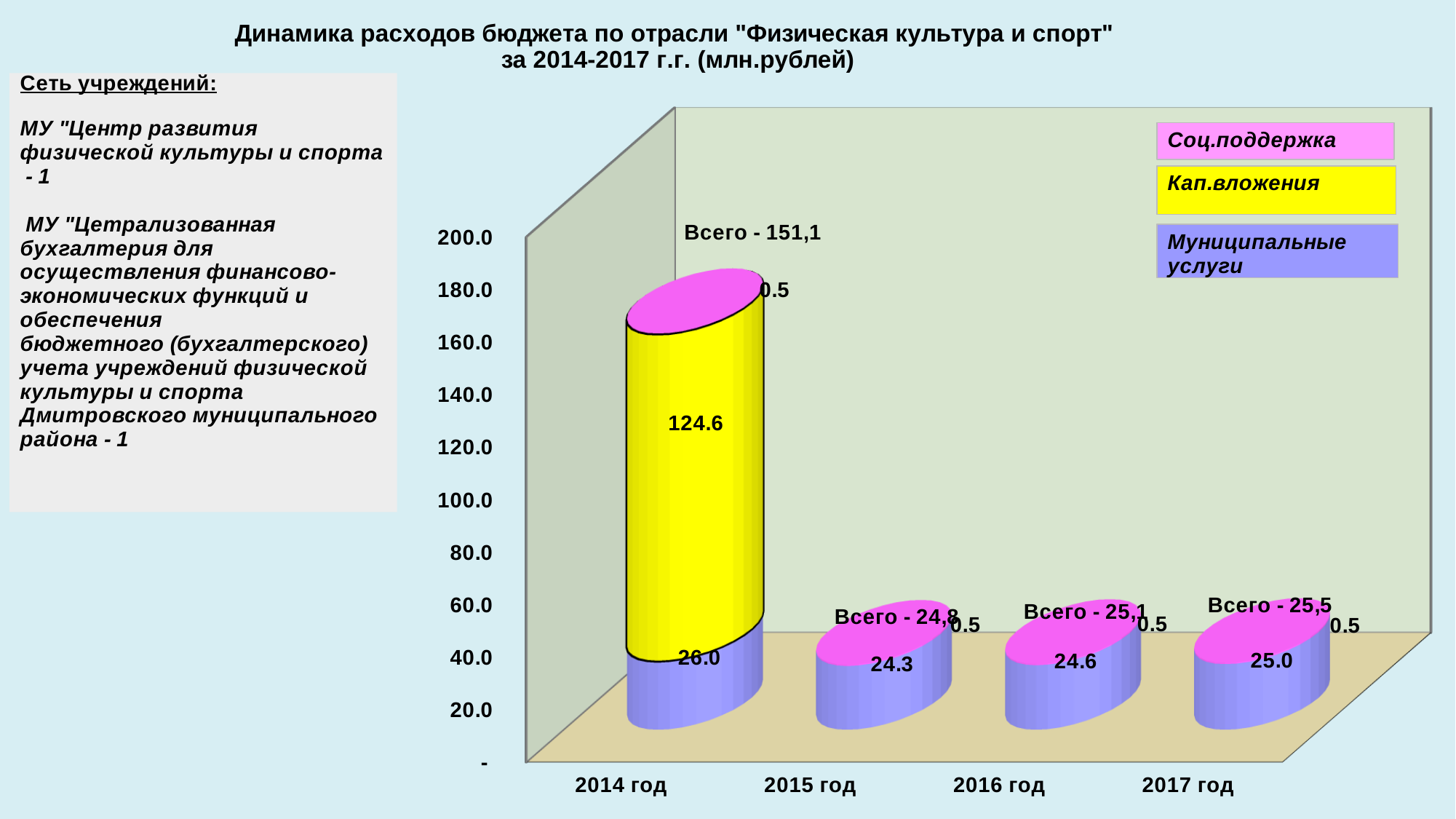
What is the total (Всего) shown for 2015 год? 24,8 How many years are shown on the x axis? 4 Is the Муниципальные услуги value larger for 2016 год or 2017 год? 2017 год What is the difference between the Муниципальные услуги values for 2017 год and 2015 год? 0.7 Which year has the lowest total expenditure? 2015 год What is the value of Муниципальные услуги for 2014 год? 26.0 What is the value of Кап.вложения for 2014 год? 124.6 What is the total (Всего) shown for 2014 год? 151,1 How many series does the legend list? 3 Which year has the highest total expenditure? 2014 год What is the value of Соц.поддержка for 2017 год? 0.5 What is the value of Муниципальные услуги for 2016 год? 24.6